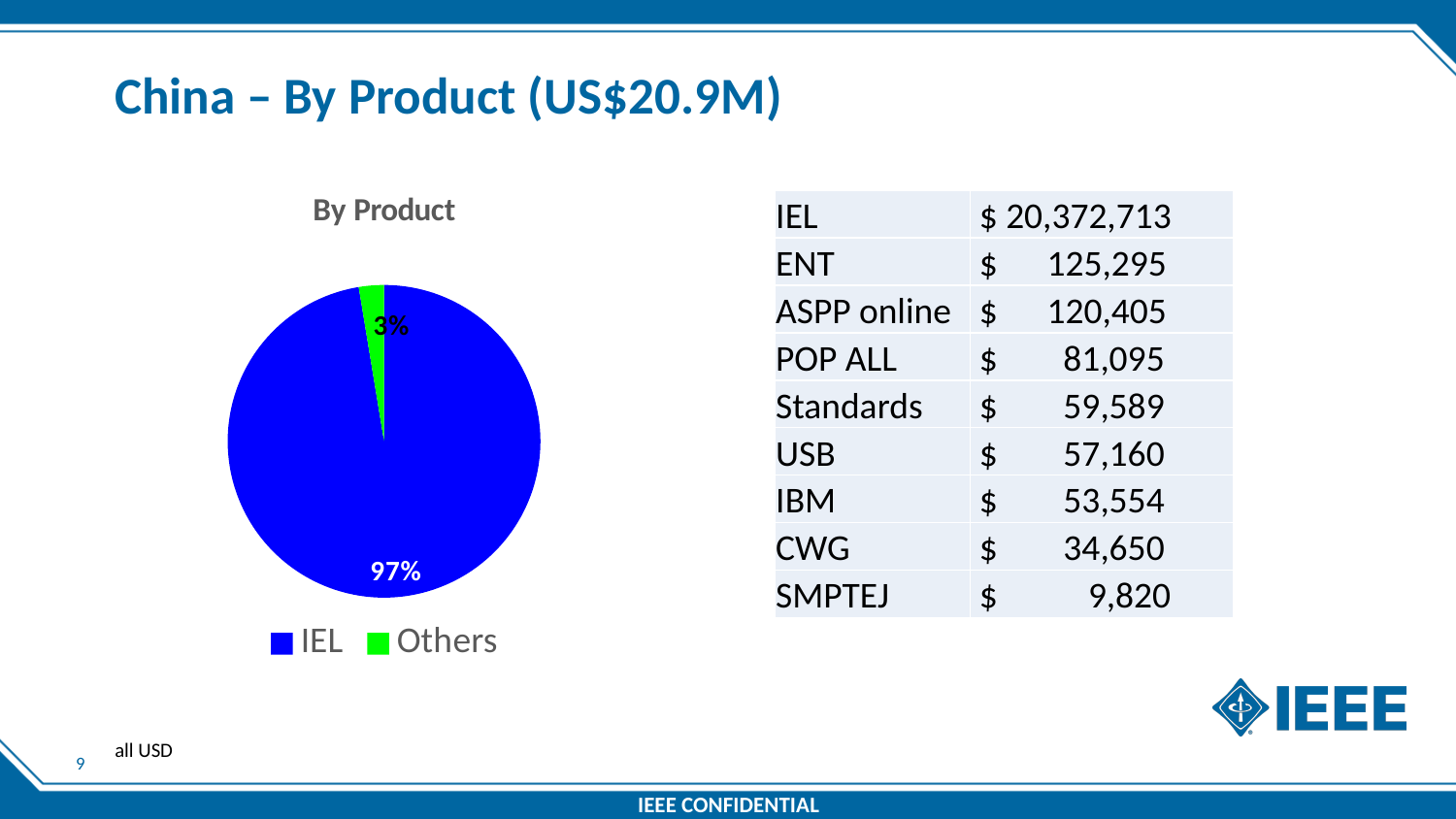
What is the difference in percentage points between the IEL slice and the Others slice? 94 How many slices does the pie chart have? 2 How many entries does the chart legend list? 2 What type of chart is shown on the slide? pie chart Which is larger, the IEL slice or the Others slice? IEL Which slice of the pie is the smallest? Others What colour is the Others slice in the pie chart? green What share of the pie does Others represent? 3% What is the title of the chart? By Product What share of the pie does IEL represent? 97% Which slice of the pie is the largest? IEL